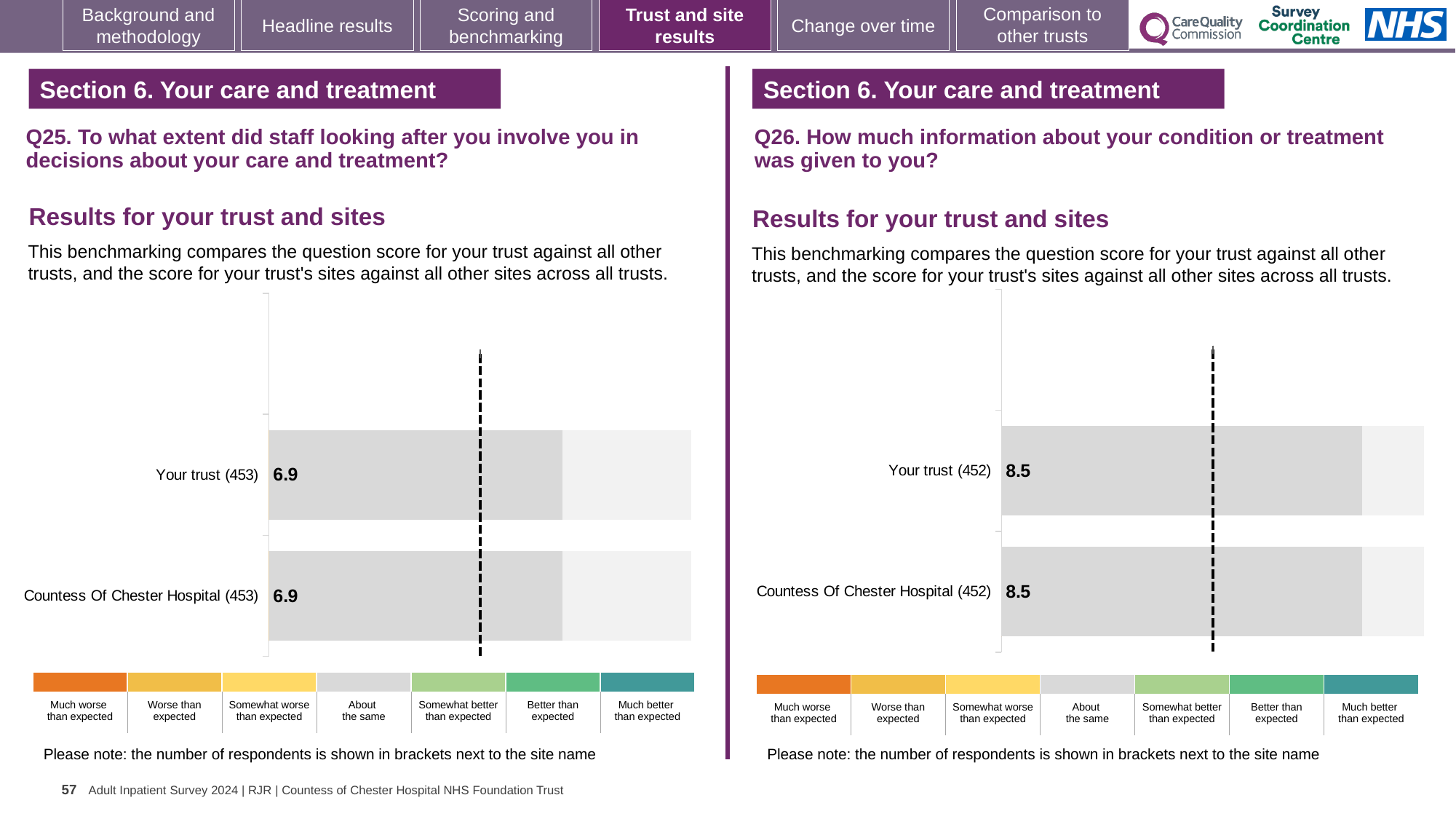
In the Q25 chart on the left, what is the score for Countess Of Chester Hospital? 6.9 In the Q25 chart on the left, what is the difference between the score for Your trust and the score for Countess Of Chester Hospital? 0 How many bars are plotted in the Q25 chart on the left? 2 In the Q26 chart on the right, what is the score for Countess Of Chester Hospital? 8.5 How many bars are plotted in the Q26 chart on the right? 2 In the Q26 chart on the right, what is the difference between the score for Your trust and the score for Countess Of Chester Hospital? 0 In the Q26 chart on the right, what is the score for Your trust? 8.5 In the Q25 chart on the left, how many respondents are shown in brackets next to Your trust? 453 In the Q26 chart on the right, how many respondents are shown in brackets next to Countess Of Chester Hospital? 452 What kind of chart is used for the Q25 results on the left? Bar chart In the Q25 chart on the left, what is the score for Your trust? 6.9